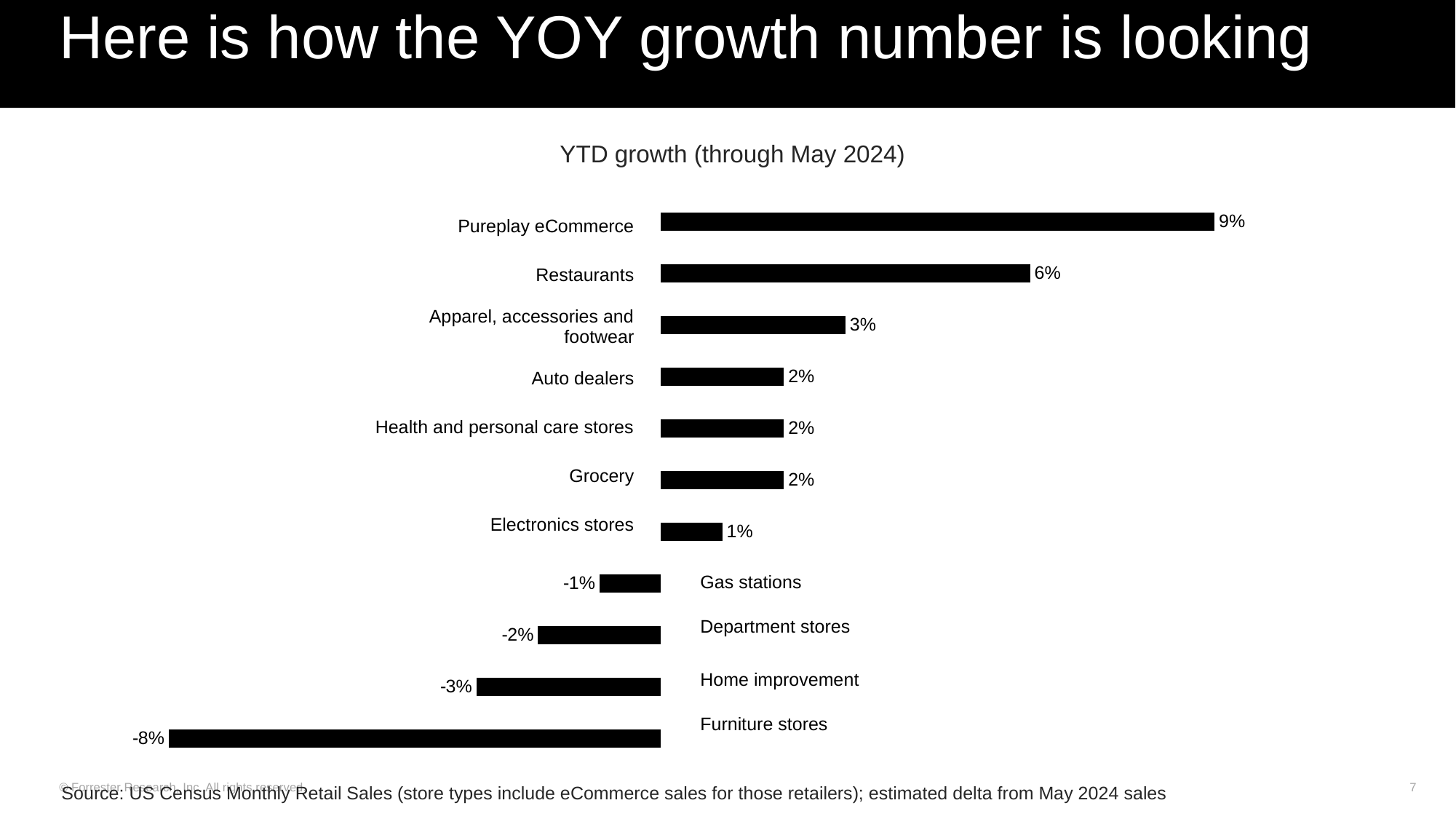
What kind of chart is shown on the slide? Bar chart What is the YTD growth value for Home improvement? -3% What is the title of the chart? YTD growth (through May 2024) What is the YTD growth value for Furniture stores? -8% What is the YTD growth value for Restaurants? 6% What is the difference between the YTD growth of Pureplay eCommerce and Restaurants? 3 percentage points Which category has the highest YTD growth? Pureplay eCommerce Which has a higher YTD growth value, Apparel, accessories and footwear or Department stores? Apparel, accessories and footwear What is the YTD growth value for Pureplay eCommerce? 9% Which category has the lowest YTD growth? Furniture stores What is the YTD growth value for Electronics stores? 1% How many categories are shown in the chart? 11